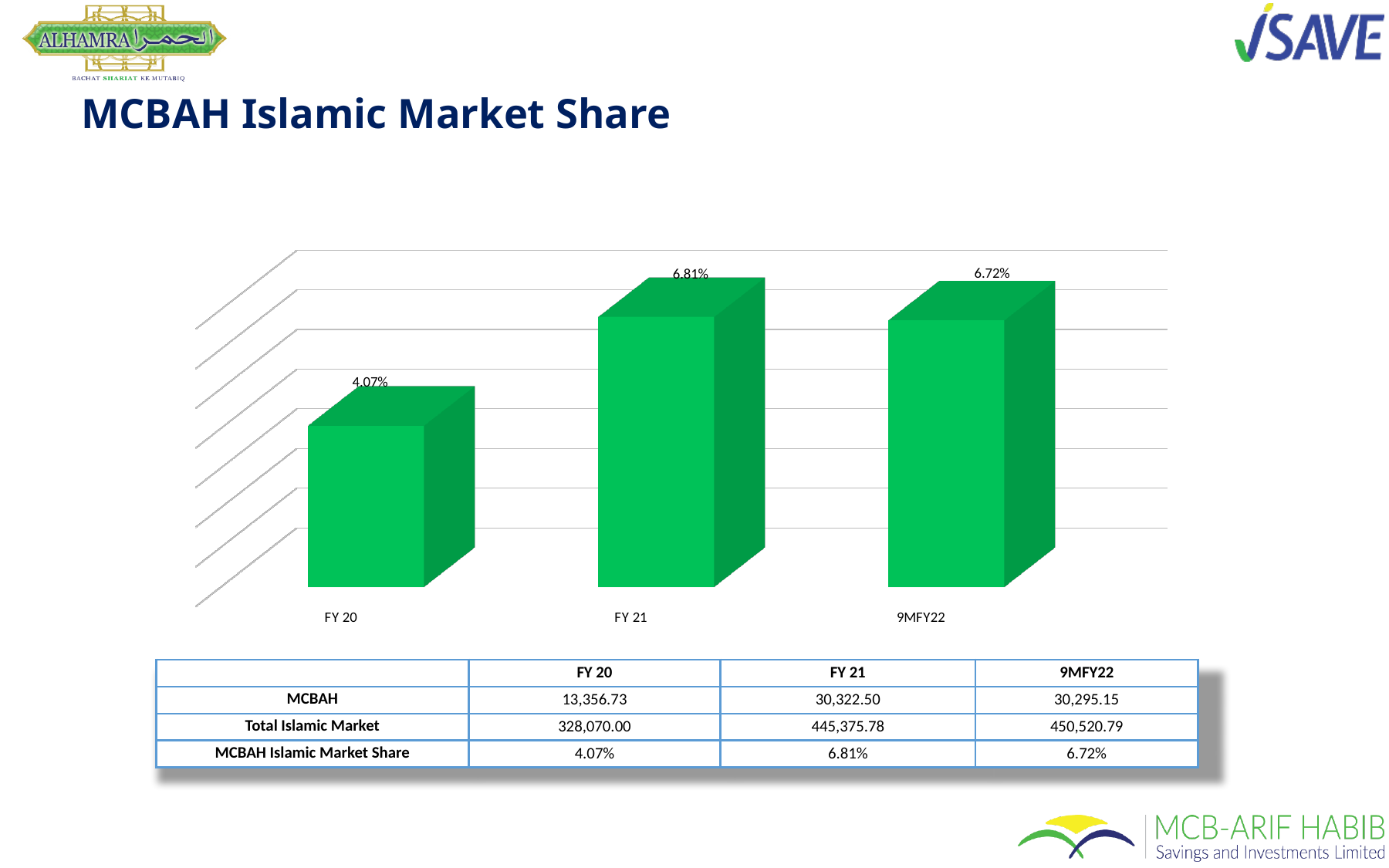
How many periods are shown on the chart? 3 What is the title of the slide? MCBAH Islamic Market Share What is the MCBAH Islamic market share for FY 21? 6.81% What is the MCBAH Islamic market share for FY 20? 4.07% Which period has the lowest MCBAH Islamic market share? FY 20 What is the difference in market share between FY 21 and FY 20? 2.74% Which period has the highest MCBAH Islamic market share? FY 21 Does the market share rise or fall from FY 20 to FY 21? Rise What kind of chart is shown on the slide? Bar chart Which is larger, the market share for FY 20 or for 9MFY22? 9MFY22 What is the MCBAH Islamic market share for 9MFY22? 6.72% What is the difference in market share between FY 21 and 9MFY22? 0.09%